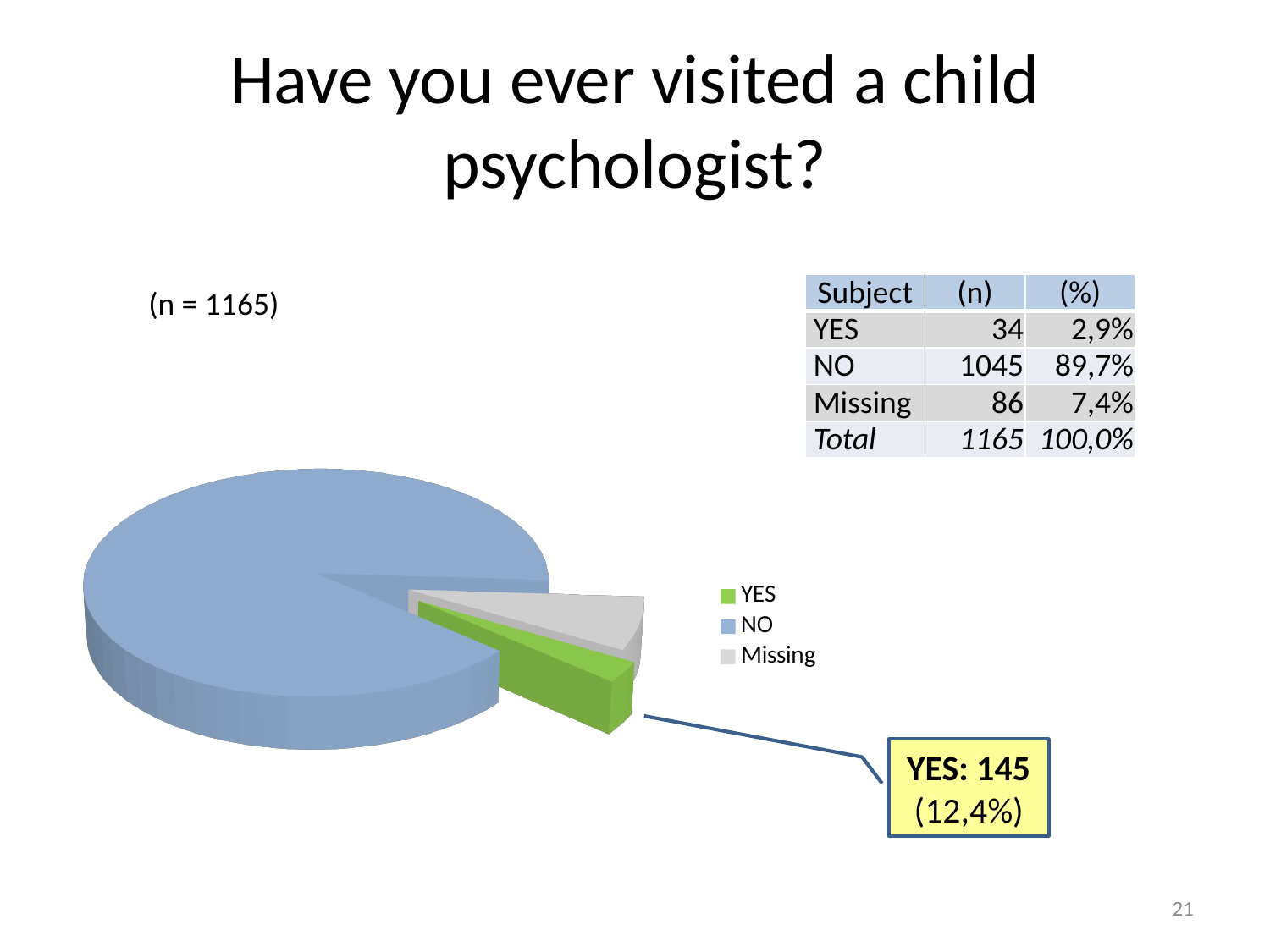
What is the title of the slide containing the pie chart? Have you ever visited a child psychologist? What is the difference in count between NO and Missing in the table? 959 What is the total number of subjects (n) shown on the slide? 1165 According to the table, how many subjects answered NO? 1045 How many entries does the legend of the pie chart list? 3 According to the table, how many subjects are listed as Missing? 86 Which category has the largest slice of the pie chart? NO According to the table, what percentage of subjects are Missing? 7,4% According to the table, what percentage of subjects answered NO? 89,7% What colour is the NO slice of the pie chart? blue What kind of chart is shown on the slide? pie chart Which is larger, the NO slice or the Missing slice? NO